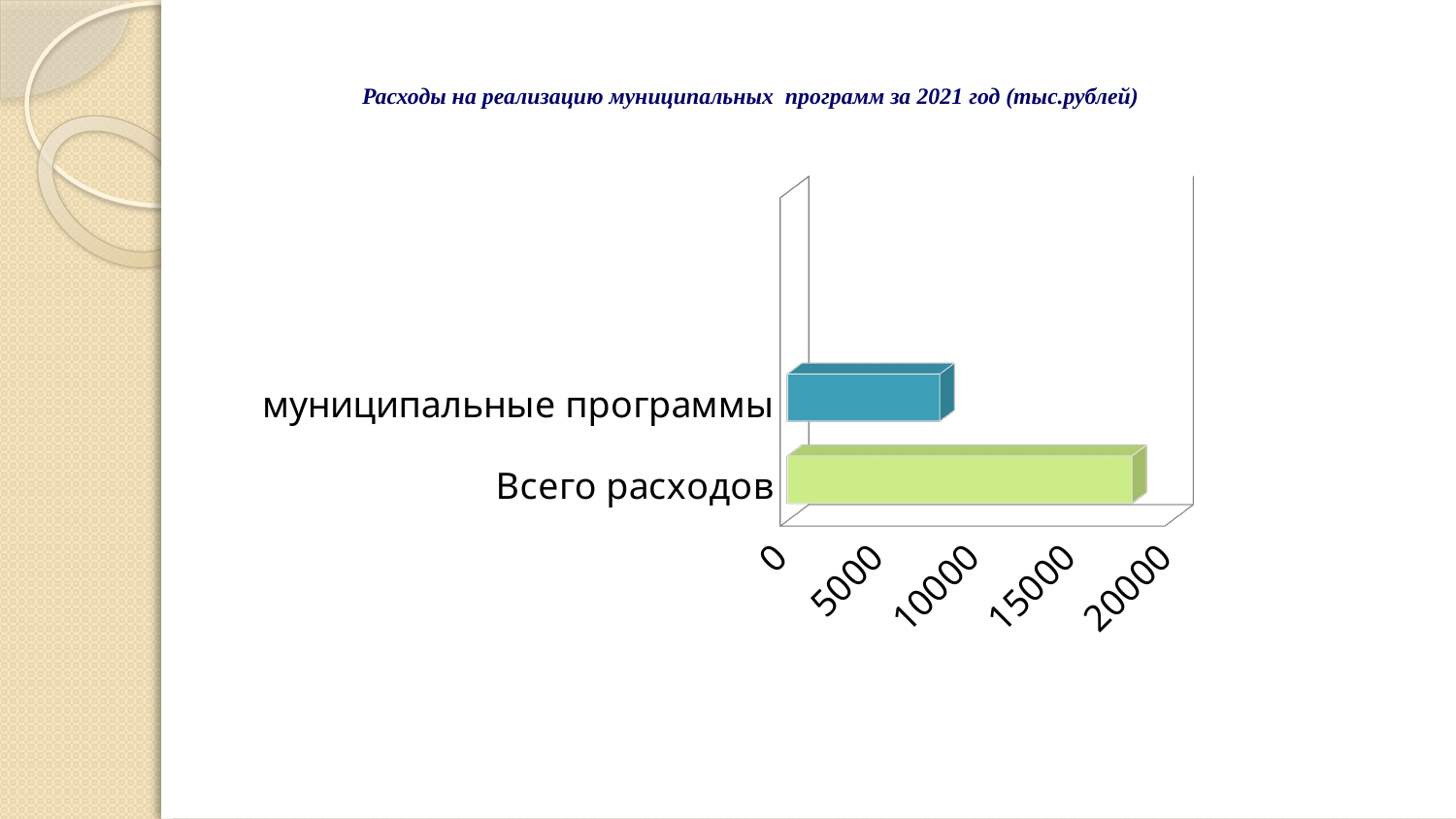
What is the title of the chart on the slide? Расходы на реализацию муниципальных программ за 2021 год (тыс.рублей) Which category has the lowest value in the chart? муниципальные программы Is the value for Всего расходов greater or less than 15000? greater What colour is the bar for Всего расходов? light green Is the value for Всего расходов greater or less than 20000? less Is the value for муниципальные программы greater or less than 10000? less Which is larger, the value for Всего расходов or the value for муниципальные программы? Всего расходов What kind of chart is shown on the slide? bar chart Which category has the highest value in the chart? Всего расходов How many categories are plotted in the chart? 2